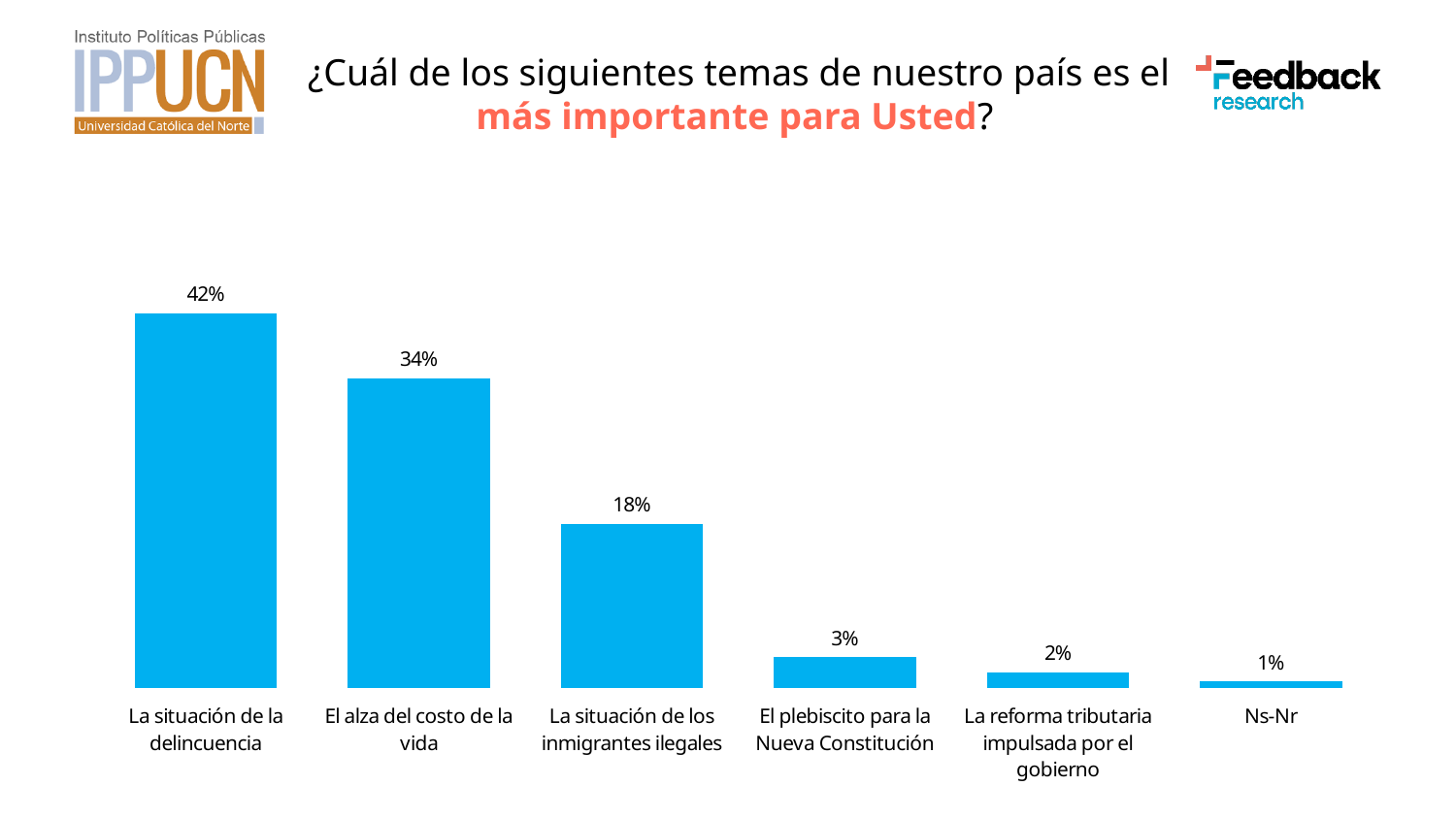
What is the value for "La situación de la delincuencia"? 42% What kind of chart is shown on the slide? Bar chart What is the value for "La situación de los inmigrantes ilegales"? 18% Do the values rise or fall from left to right along the x axis? Fall What is the value for "Ns-Nr"? 1% What is the difference between the values for "La situación de la delincuencia" and "El alza del costo de la vida"? 8% What is the value for "El alza del costo de la vida"? 34% How many categories are shown in the chart? 6 Which category has the highest value? La situación de la delincuencia Which category has the lowest value? Ns-Nr What is the value for "El plebiscito para la Nueva Constitución"? 3% Which is larger, the value for "La reforma tributaria impulsada por el gobierno" or the value for "El plebiscito para la Nueva Constitución"? El plebiscito para la Nueva Constitución